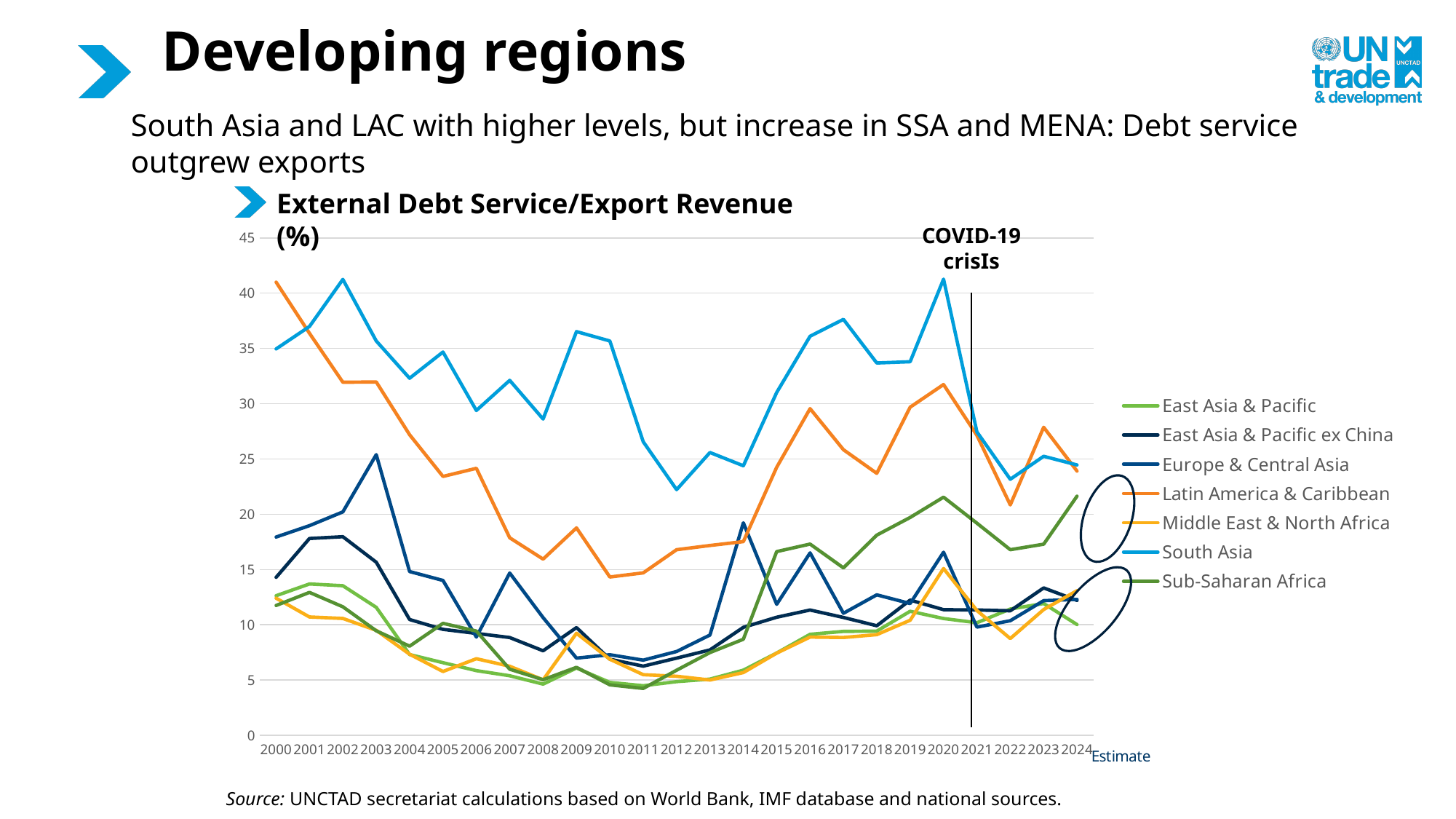
In 2000, which is higher: South Asia or Latin America & Caribbean? Latin America & Caribbean How many series does the legend list? 7 How many years are shown on the x axis? 25 Is the value for Sub-Saharan Africa in 2011 greater or less than 10? less What kind of chart is shown on the slide? line chart Which series has the highest value in 2020? South Asia Is the value for East Asia & Pacific in 2024 greater or less than 15? less Does the Latin America & Caribbean line rise or fall from 2000 to 2007? fall Is the value for Latin America & Caribbean in 2000 greater or less than 35? greater What event does the vertical line on the chart mark? COVID-19 crisis In 2024, which is higher: Sub-Saharan Africa or East Asia & Pacific? Sub-Saharan Africa